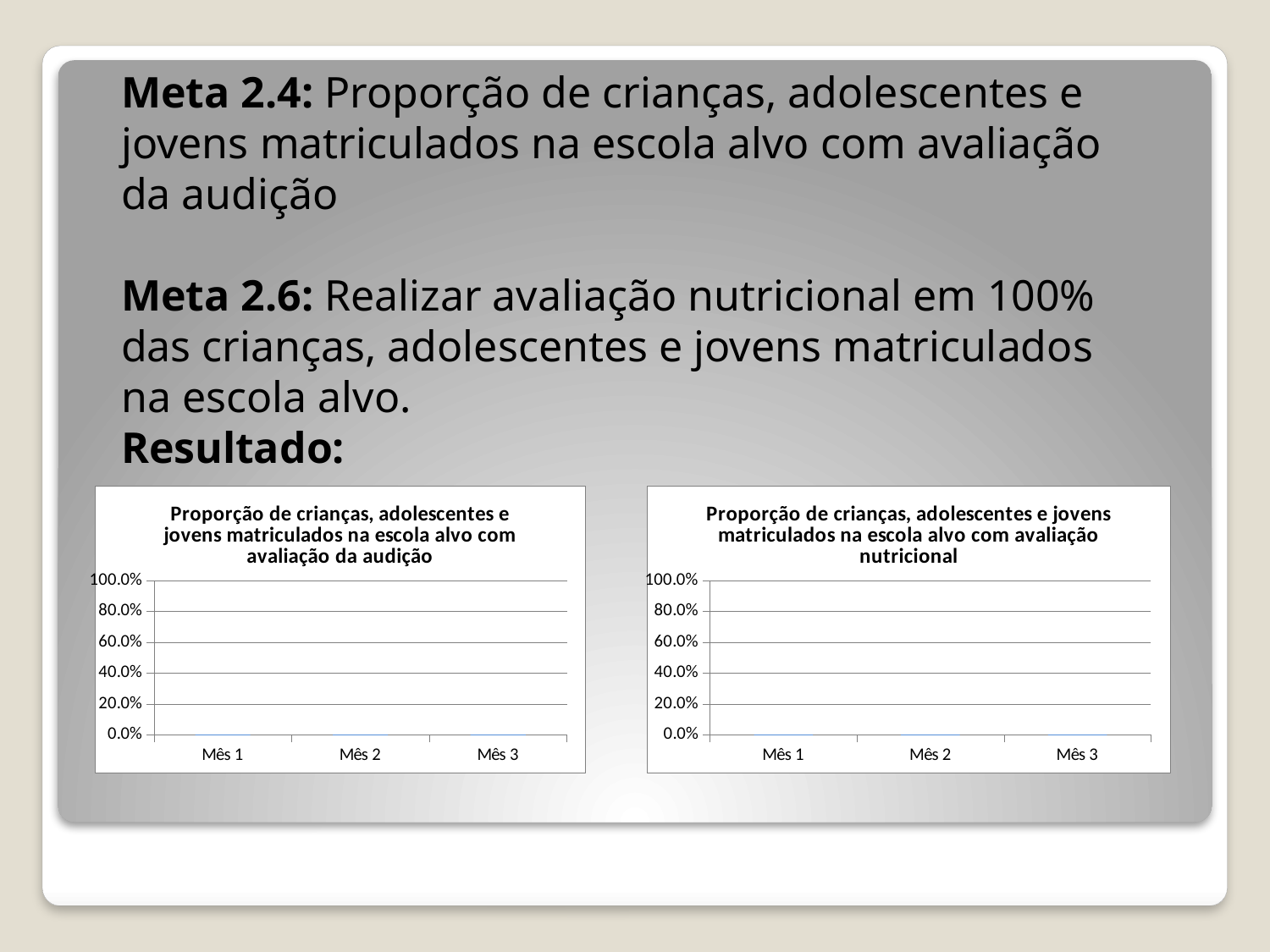
In the right chart (avaliação nutricional), how many categories are shown on the x axis? 3 What are the category labels on the x axis of the right chart (avaliação nutricional)? Mês 1, Mês 2, Mês 3 What is the title of the right chart? Proporção de crianças, adolescentes e jovens matriculados na escola alvo com avaliação nutricional In the left chart (avaliação da audição), how many categories are shown on the x axis? 3 In the left chart (avaliação da audição), is the value for Mês 2 greater or less than 40.0%? less What is the highest value shown on the y axis of the left chart (avaliação da audição)? 100.0% In the left chart (avaliação da audição), is the value for Mês 1 greater or less than 20.0%? less What kind of chart is the left chart (avaliação da audição)? bar chart What kind of chart is the right chart (avaliação nutricional)? bar chart In the right chart (avaliação nutricional), is the value for Mês 3 greater or less than 20.0%? less